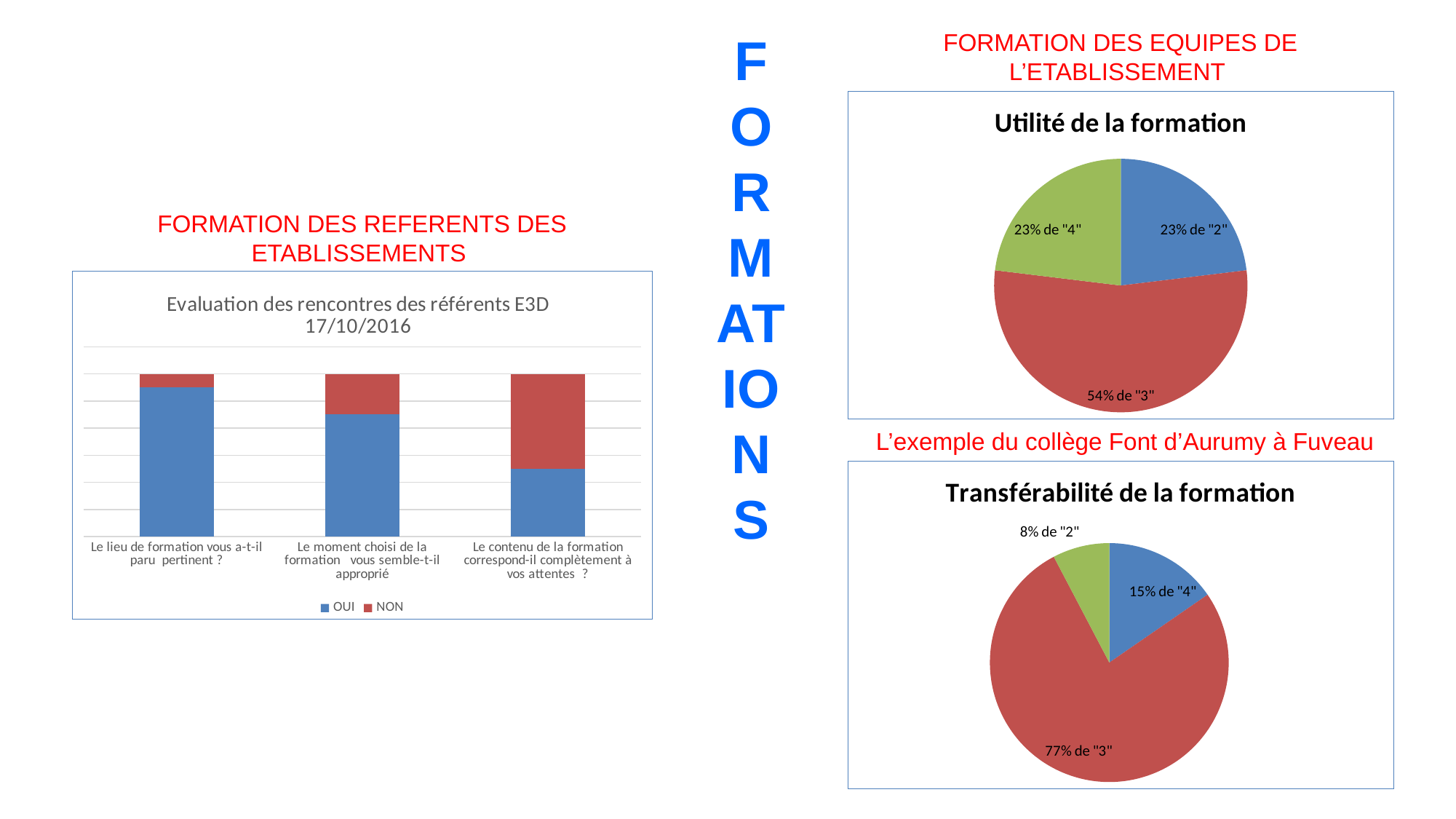
In the 'Utilité de la formation' pie chart, what share of responses is '3'? 54% In the 'Utilité de la formation' pie chart, what share of responses is '2'? 23% What kind of chart is the 'Evaluation des rencontres des référents E3D 17/10/2016' chart? Bar chart In the 'Transférabilité de la formation' pie chart, what share of responses is '3'? 77% What kind of chart is 'Utilité de la formation'? Pie chart What are the two legend entries of the 'Evaluation des rencontres des référents E3D 17/10/2016' chart? OUI and NON How many series does the legend of the 'Evaluation des rencontres des référents E3D 17/10/2016' chart list? 2 In the 'Transférabilité de la formation' pie chart, which response has the smallest slice? "2" How many questions (categories) are shown on the x axis of the 'Evaluation des rencontres des référents E3D 17/10/2016' chart? 3 In the 'Utilité de la formation' pie chart, which response has the largest slice? "3" How many slices does the 'Transférabilité de la formation' pie chart have? 3 In the 'Evaluation des rencontres des référents E3D 17/10/2016' chart, which question has the largest NON portion? Le contenu de la formation correspond-il complètement à vos attentes ?